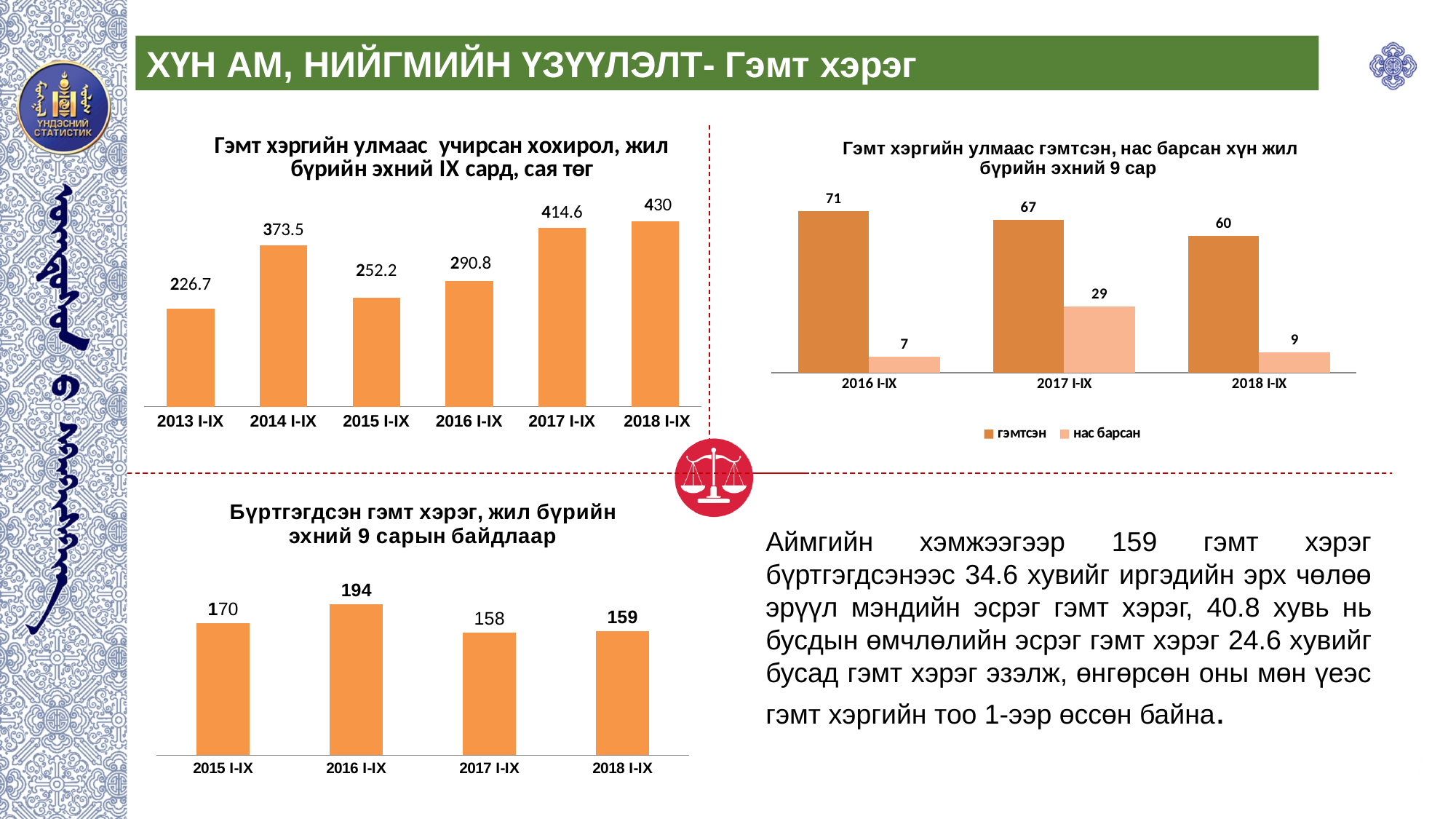
In the top-right chart (Гэмт хэргийн улмаас гэмтсэн, нас барсан хүн), how many series does the legend list? 2 In the bottom-left chart (Бүртгэгдсэн гэмт хэрэг), what is the value for 2016 I-IX? 194 In the top-right chart (Гэмт хэргийн улмаас гэмтсэн, нас барсан хүн), what is the value for нас барсан in 2017 I-IX? 29 In the top-right chart (Гэмт хэргийн улмаас гэмтсэн, нас барсан хүн), which year has the highest гэмтсэн value? 2016 I-IX In the bottom-left chart (Бүртгэгдсэн гэмт хэрэг), what is the difference between the 2016 I-IX and 2017 I-IX values? 36 In the top-left chart (Гэмт хэргийн улмаас учирсан хохирол), which year has the lowest value? 2013 I-IX In the bottom-left chart (Бүртгэгдсэн гэмт хэрэг), which is larger: the value for 2015 I-IX or 2018 I-IX? 2015 I-IX In the top-left chart (Гэмт хэргийн улмаас учирсан хохирол), what is the difference between the 2017 I-IX and 2016 I-IX values? 123.8 In the top-left chart (Гэмт хэргийн улмаас учирсан хохирол), what is the value for 2018 I-IX? 430 What type of chart is the bottom-left chart (Бүртгэгдсэн гэмт хэрэг)? bar chart In the top-left chart (Гэмт хэргийн улмаас учирсан хохирол), how many years are shown? 6 In the top-right chart (Гэмт хэргийн улмаас гэмтсэн, нас барсан хүн), does the гэмтсэн value rise or fall from 2016 I-IX to 2018 I-IX? fall